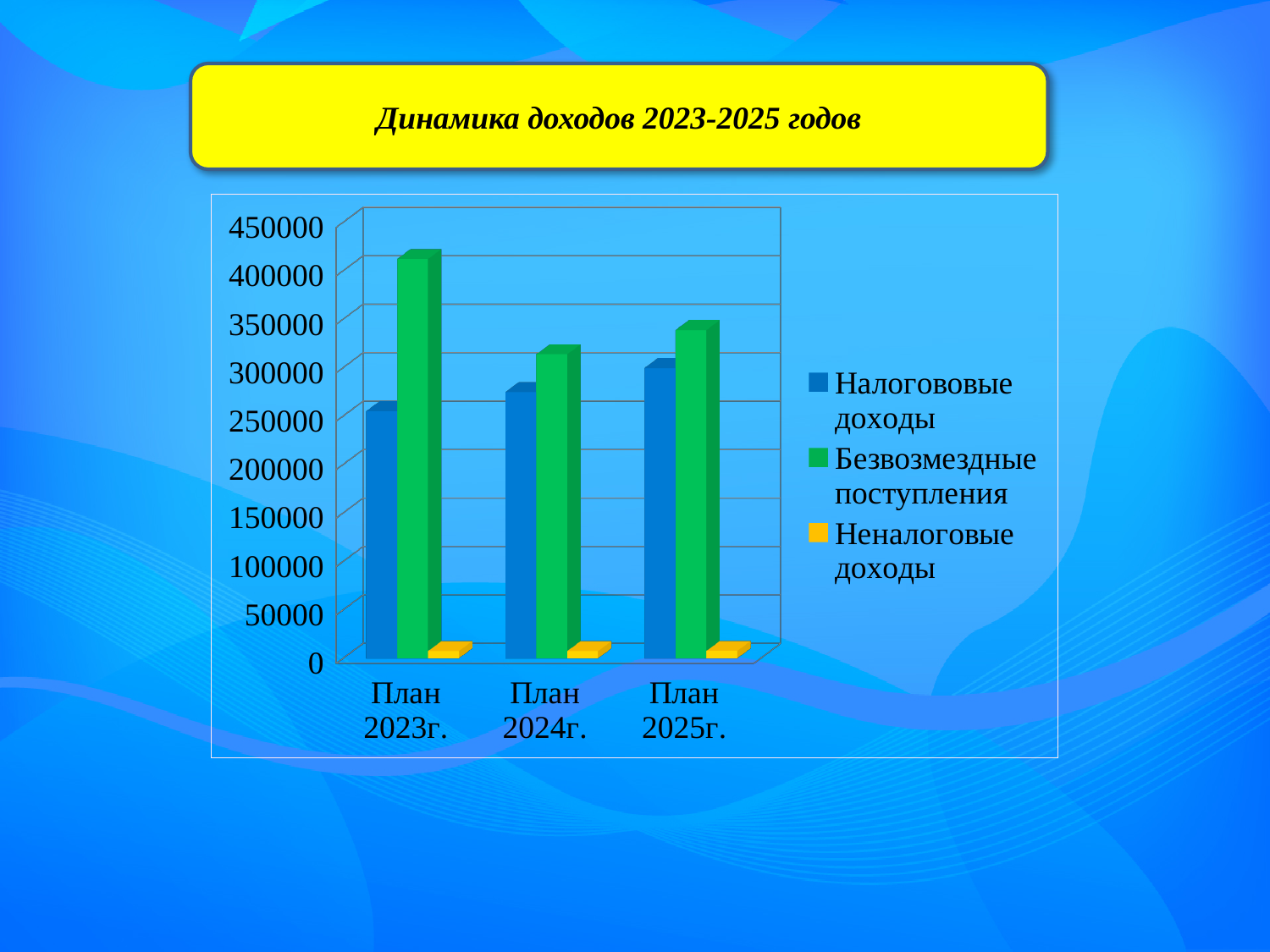
Is the value for Неналоговые доходы in План 2024г. greater or less than 50000? less What is the title shown above the chart? Динамика доходов 2023-2025 годов How many categories (years) are shown on the x axis of the chart? 3 Which series has the lowest value in every year shown? Неналоговые доходы Is the value of Безвозмездные поступления larger for План 2023г. or for План 2025г.? План 2023г. Which series is shown in green in the chart? Безвозмездные поступления How many series does the chart legend list? 3 Do the values for Налогововые доходы rise or fall from План 2023г. to План 2025г.? Rise What kind of chart is shown on the slide? Bar chart Which is larger for План 2023г.: Налогововые доходы or Безвозмездные поступления? Безвозмездные поступления Is the value for Безвозмездные поступления in План 2023г. greater or less than 350000? greater Which series has the tallest bar in the chart overall? Безвозмездные поступления